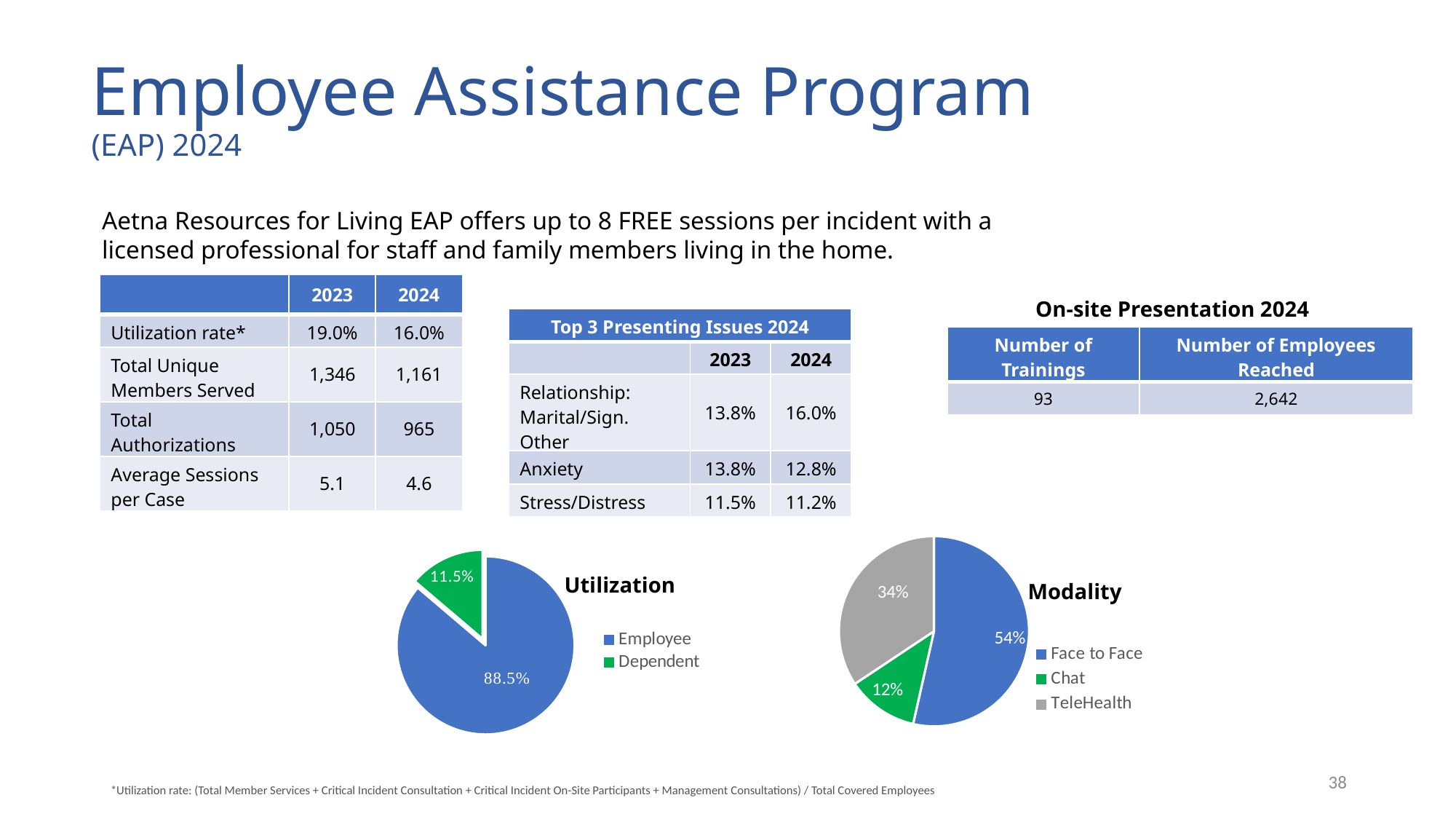
In the Utilization pie chart, what share is labelled for Dependent? 11.5% How many series does the legend of the Utilization pie chart list? 2 In the Modality pie chart, which slice is the smallest? Chat In the Modality pie chart, what share is labelled for Face to Face? 54% In the Utilization pie chart, which slice is the largest? Employee In the Utilization pie chart, what share is labelled for Employee? 88.5% What kind of chart is the Utilization chart? Pie chart In the Utilization pie chart, what is the difference between the Employee and Dependent shares? 77.0% In the Modality pie chart, what share is labelled for TeleHealth? 34% In the Modality pie chart, what share is labelled for Chat? 12% In the Modality pie chart, is the Face to Face share larger or smaller than the TeleHealth share? Larger How many slices does the Modality pie chart have? 3